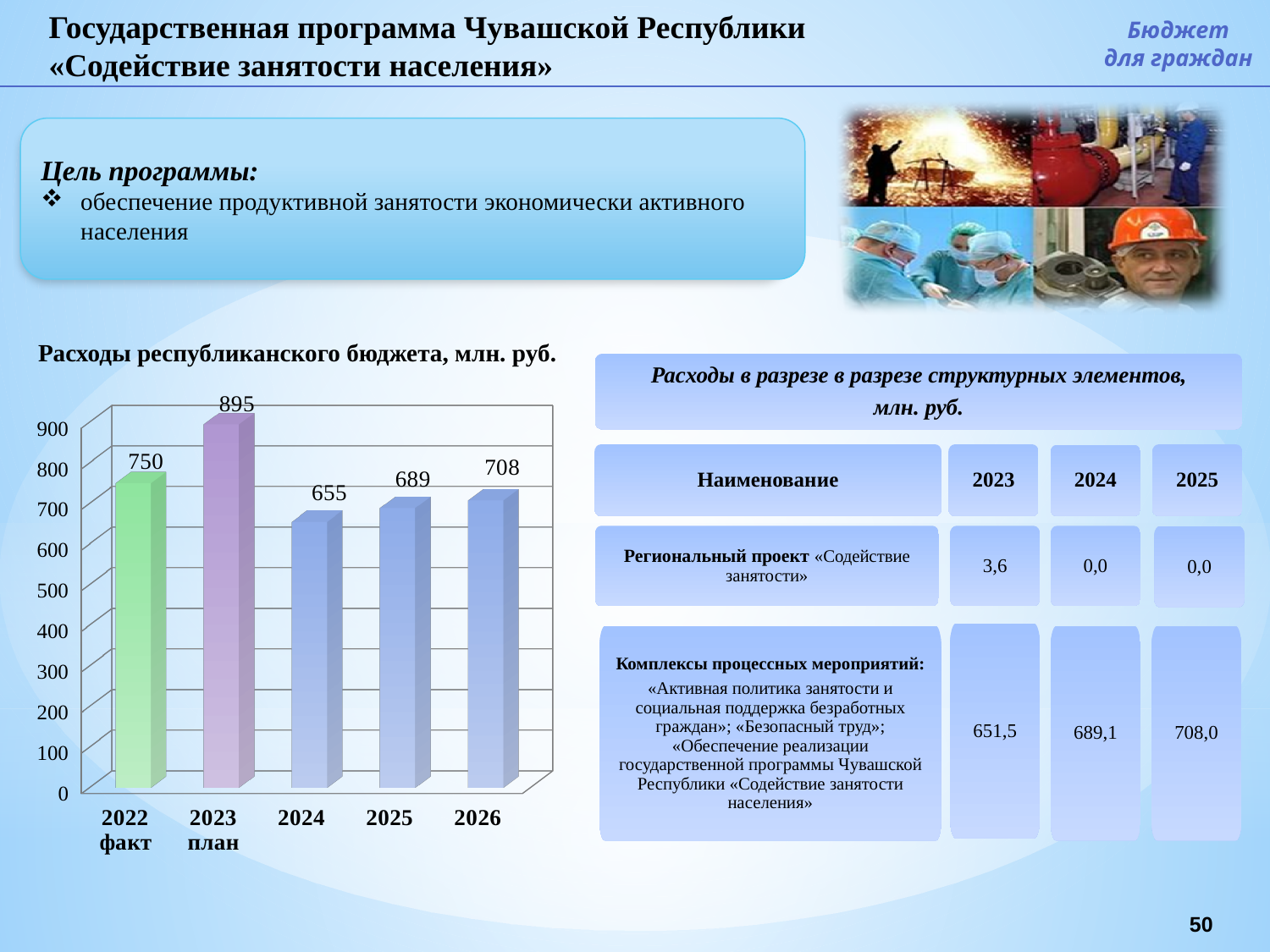
How many bars are shown in the chart? 5 What is the difference between the values for 2026 and 2025? 19 Do the values rise or fall from 2024 to 2026? rise Which year has the lowest value in the chart? 2024 Which year has the highest value in the chart? 2023 план What is the value for 2022 факт in the chart? 750 What is the difference between the values for 2023 план and 2024? 240 What is the value for 2023 план in the chart "Расходы республиканского бюджета, млн. руб."? 895 Which is larger, the value for 2022 факт or the value for 2026? 2022 факт What kind of chart is shown on the slide? bar chart What is the value for 2025 in the chart? 689 Is the value for 2024 greater or less than 700? less